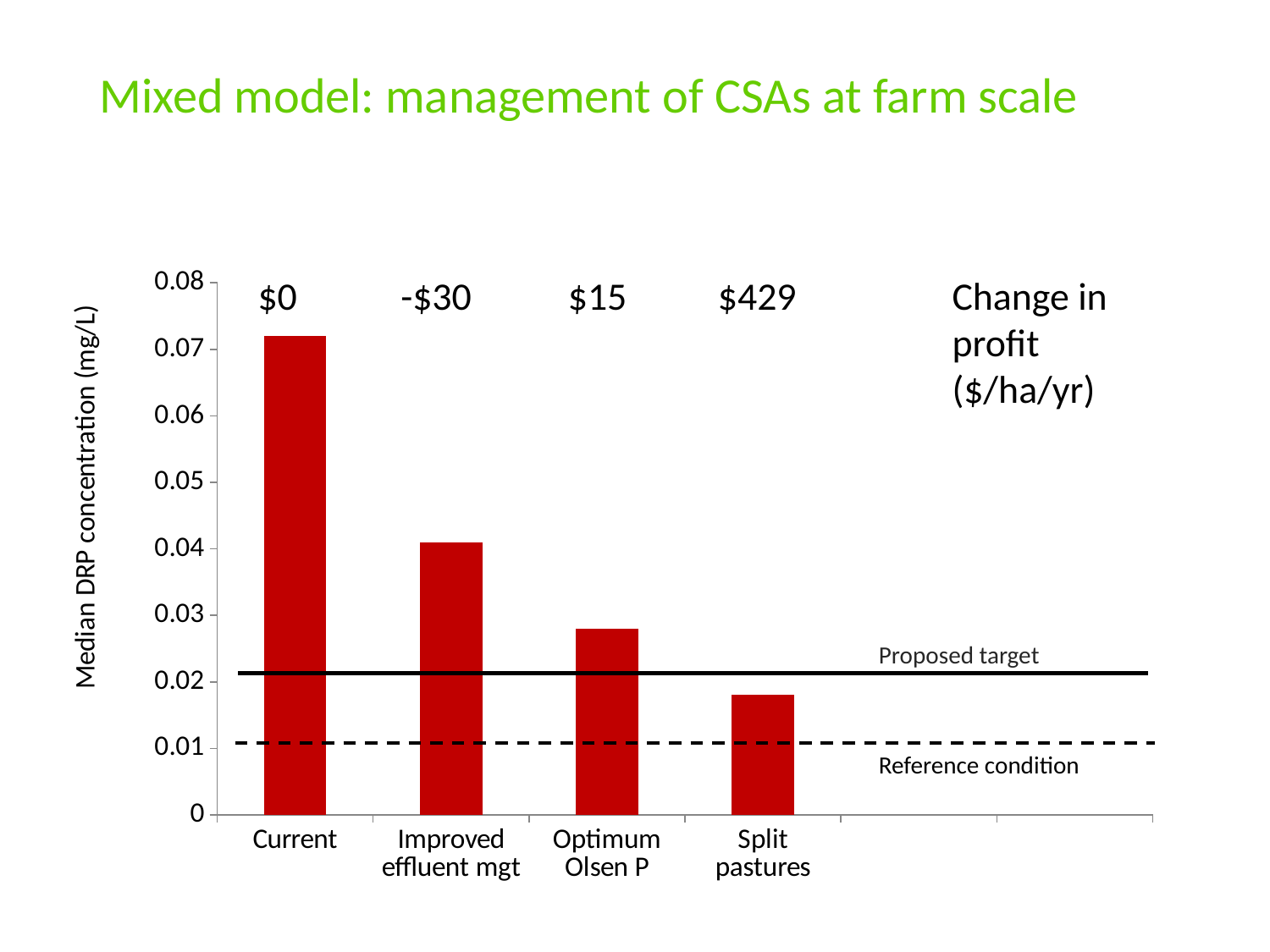
What is the label of the y axis? Median DRP concentration (mg/L) Which has a higher median DRP concentration, Improved effluent mgt or Optimum Olsen P? Improved effluent mgt Is the median DRP concentration for Split pastures greater or less than 0.03? less What is the change in profit ($/ha/yr) shown for Split pastures? $429 What kind of chart is shown on the slide? bar chart Which scenario has the highest median DRP concentration? Current What is the change in profit ($/ha/yr) shown for Improved effluent mgt? -$30 Is the median DRP concentration for Current greater or less than 0.06? greater Do the bar values rise or fall moving from left to right across the scenarios? fall Is the median DRP concentration for Improved effluent mgt greater or less than 0.05? less Which scenario has the lowest median DRP concentration? Split pastures How many management scenarios (bars) are plotted in the chart? 4